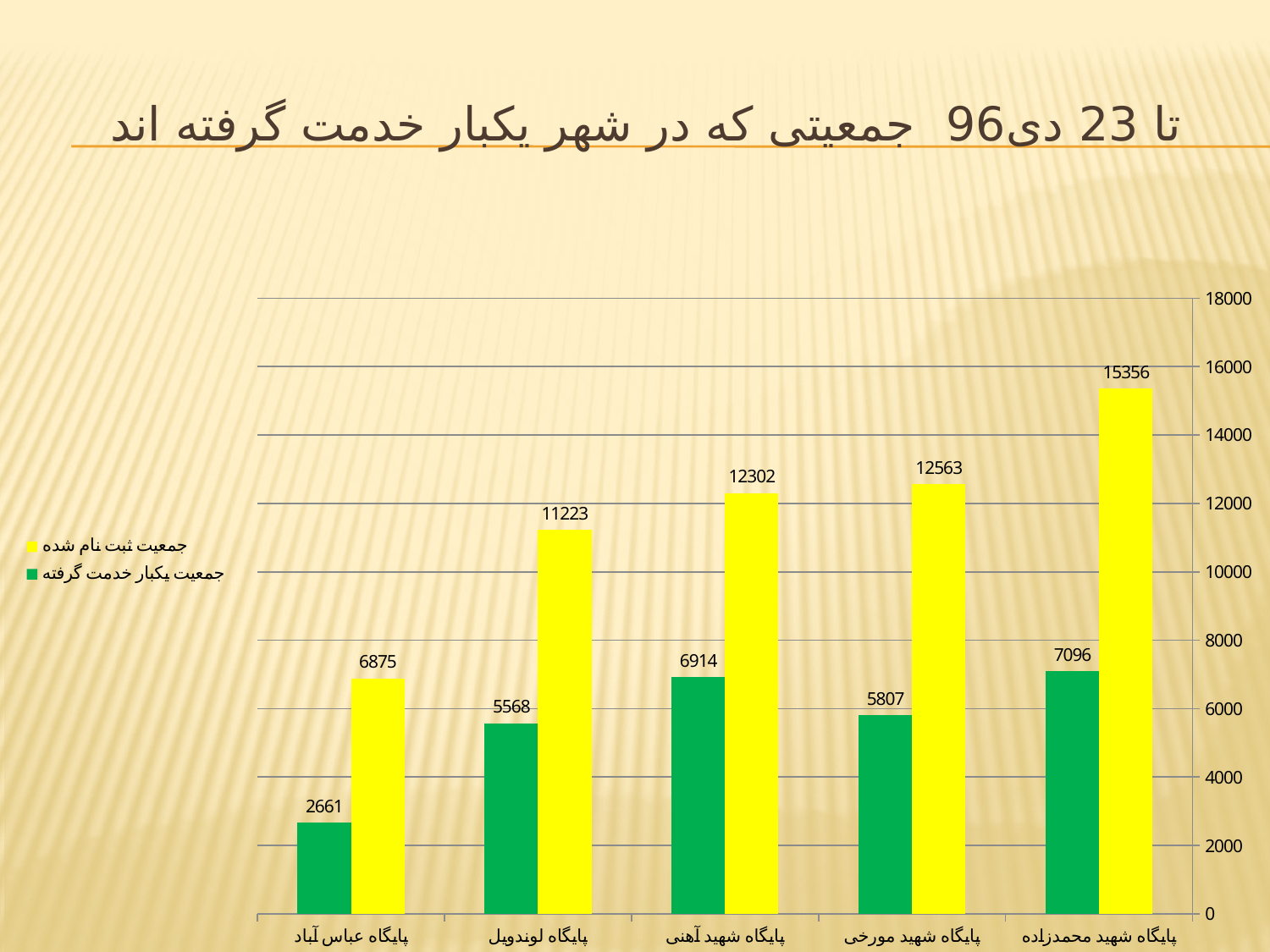
Is the value of جمعیت ثبت نام شده for پایگاه شهید مورخی greater or less than 12000? greater Which category has the highest value for جمعیت ثبت نام شده? پایگاه شهید محمدزاده How many series does the legend list? 2 What is the value of جمعیت ثبت نام شده for پایگاه لوندویل? 11223 What is the difference between جمعیت ثبت نام شده and جمعیت یکبار خدمت گرفته for پایگاه شهید آهنی? 5388 Which category has the lowest value for جمعیت یکبار خدمت گرفته? پایگاه عباس آباد What kind of chart is shown on the slide? bar chart What is the value of جمعیت ثبت نام شده for پایگاه شهید محمدزاده? 15356 Which is larger: جمعیت یکبار خدمت گرفته for پایگاه شهید آهنی or for پایگاه شهید مورخی? پایگاه شهید آهنی How many categories are shown on the x axis? 5 Which colour represents جمعیت ثبت نام شده in the legend? yellow What is the value of جمعیت یکبار خدمت گرفته for پایگاه عباس آباد? 2661